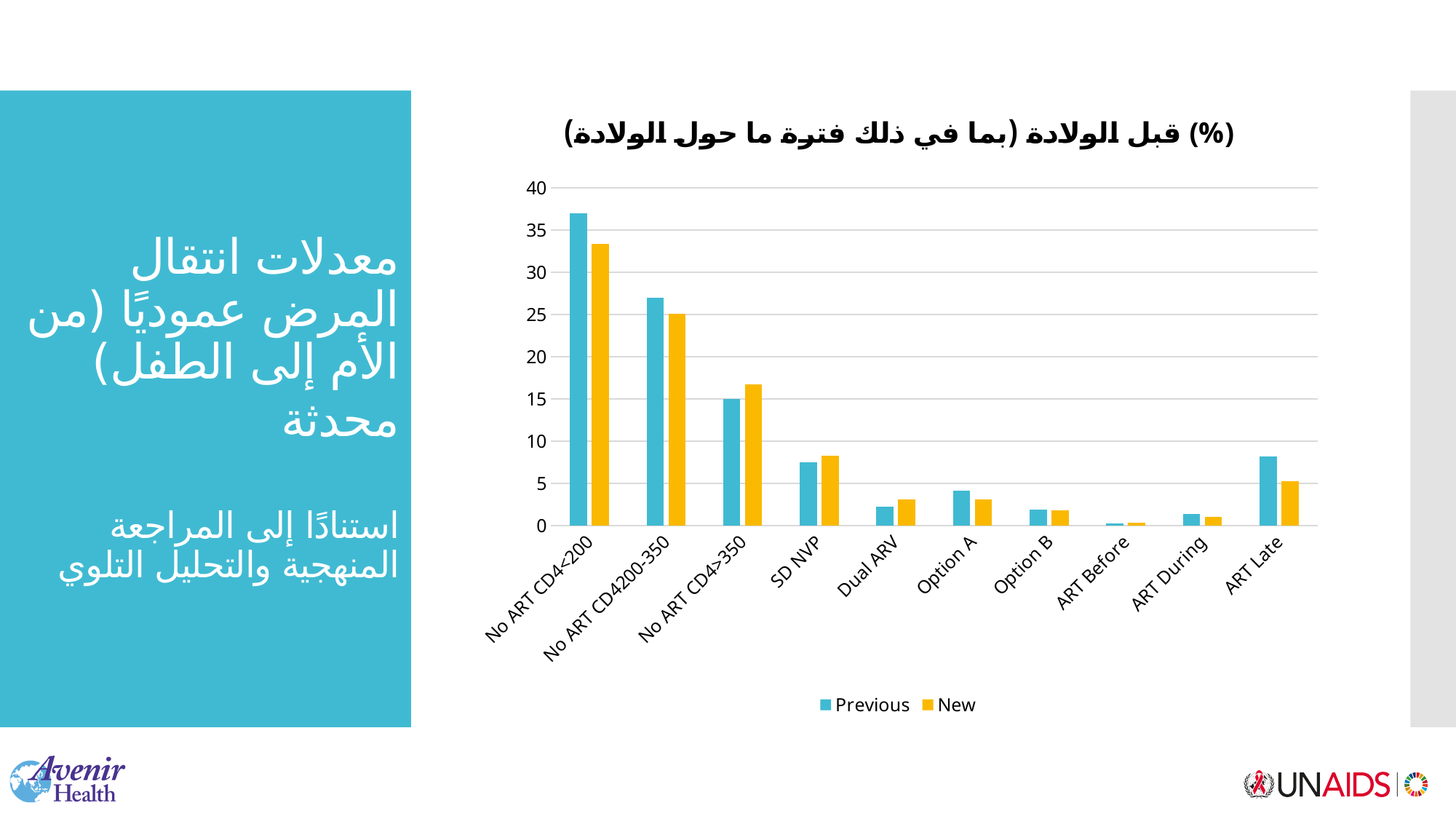
How many series does the legend list? 2 Is the Previous value for ART Late greater or less than 10? less For No ART CD4<200, which is larger, the Previous value or the New value? Previous Which colour represents the New series in the legend? yellow Which category has the highest Previous value? No ART CD4<200 For No ART CD4>350, which is larger, the Previous value or the New value? New For ART Late, which is larger, the Previous value or the New value? Previous Which category has the lowest New value? ART Before Is the New value for No ART CD4<200 greater or less than 35? less What kind of chart is shown on the slide? bar chart Is the Previous value for No ART CD4<200 greater or less than 35? greater How many categories are shown on the x axis? 10